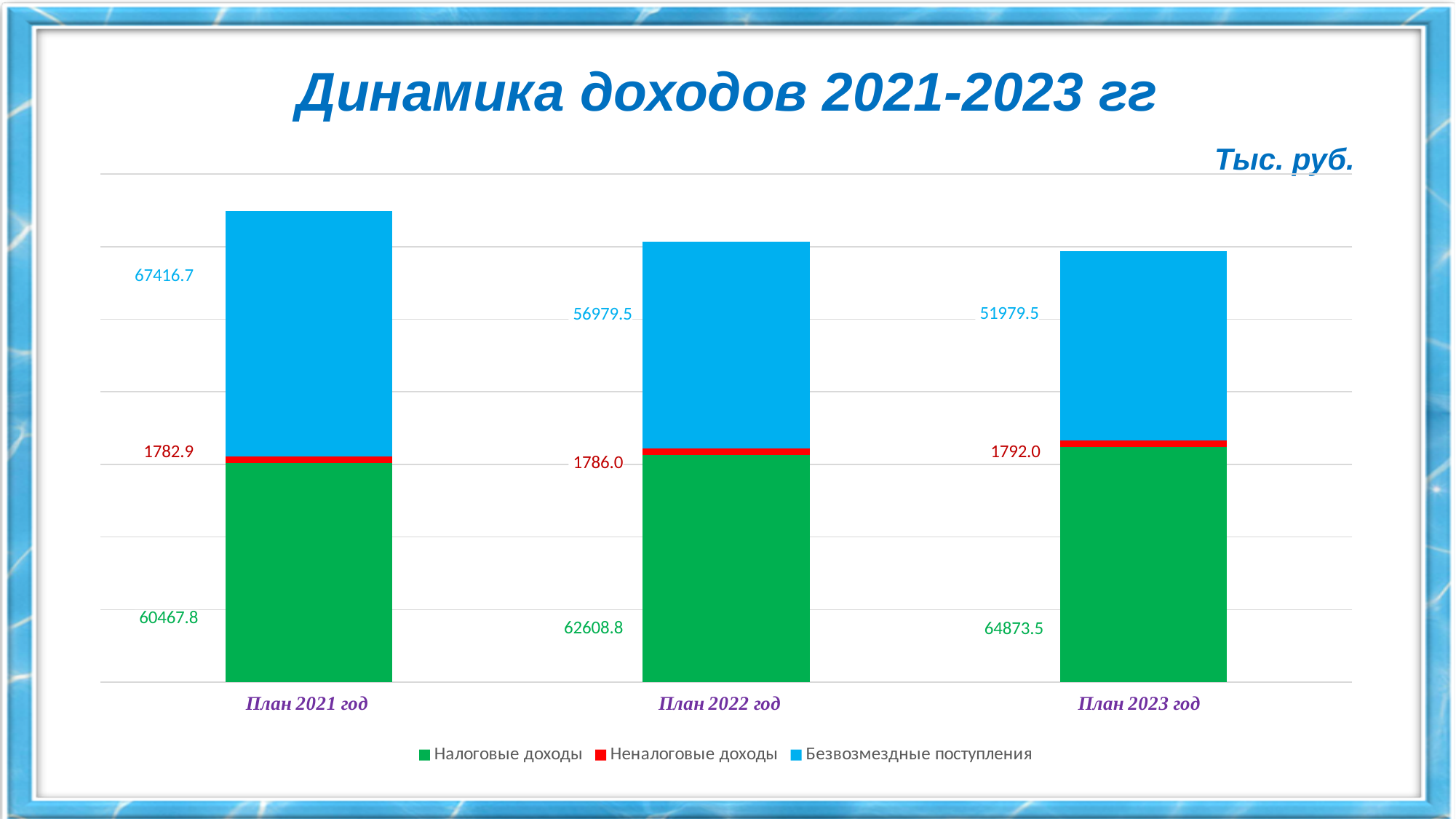
How many series does the legend list? 3 What kind of chart is shown on the slide? Stacked bar chart What is the difference between Безвозмездные поступления in План 2021 год and План 2023 год? 15437.2 What is the value of Безвозмездные поступления for План 2021 год? 67416.7 In which year is Безвозмездные поступления the lowest? План 2023 год What is the value of Неналоговые доходы for План 2023 год? 1792.0 What is the total of the stacked bar for План 2023 год? 118645.0 What is the value of Налоговые доходы for План 2022 год? 62608.8 Which is larger for План 2022 год: Налоговые доходы or Безвозмездные поступления? Налоговые доходы Do the values of Безвозмездные поступления rise or fall from План 2021 год to План 2023 год? Fall How many categories are shown on the x axis? 3 In which year is Налоговые доходы the highest? План 2023 год